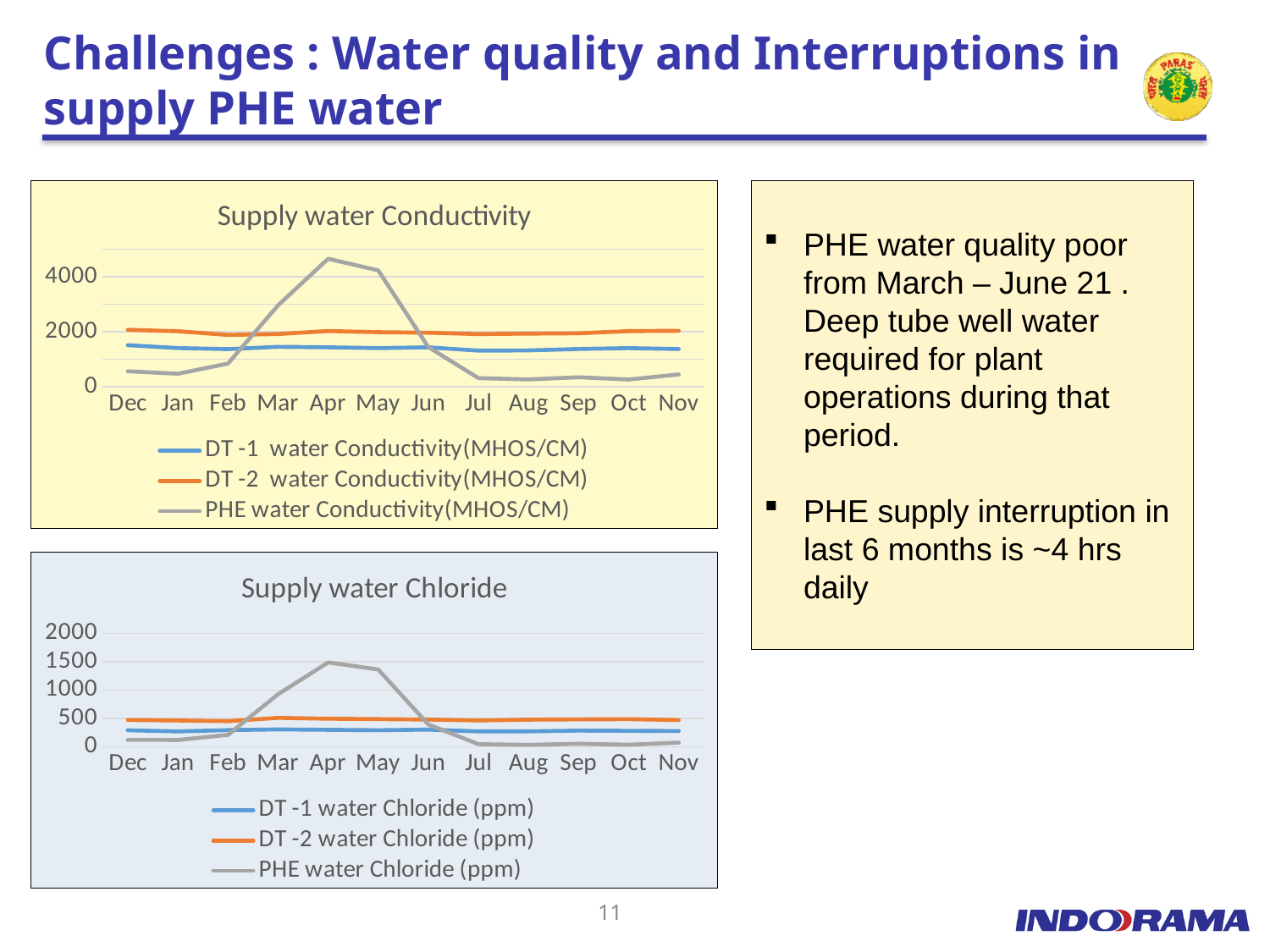
What kind of chart is the Supply water Conductivity chart? line chart In the Supply water Chloride chart, is the PHE water Chloride value for Apr greater or less than 1000? greater In the Supply water Conductivity chart, is the PHE water Conductivity value for Jul greater or less than 2000? less How many series does the legend of the Supply water Chloride chart list? 3 In the Supply water Conductivity chart, is the PHE water Conductivity value for Apr greater or less than 4000? greater In the Supply water Conductivity chart, in which month does PHE water Conductivity reach its highest value? Apr What kind of chart is the Supply water Chloride chart? line chart What is the title of the lower chart on the slide? Supply water Chloride In the Supply water Chloride chart, in which month does PHE water Chloride reach its highest value? Apr How many series does the legend of the Supply water Conductivity chart list? 3 How many months are shown on the x axis of the Supply water Conductivity chart? 12 In the Supply water Conductivity chart, which is larger in Dec: DT -1 water Conductivity or DT -2 water Conductivity? DT -2 water Conductivity